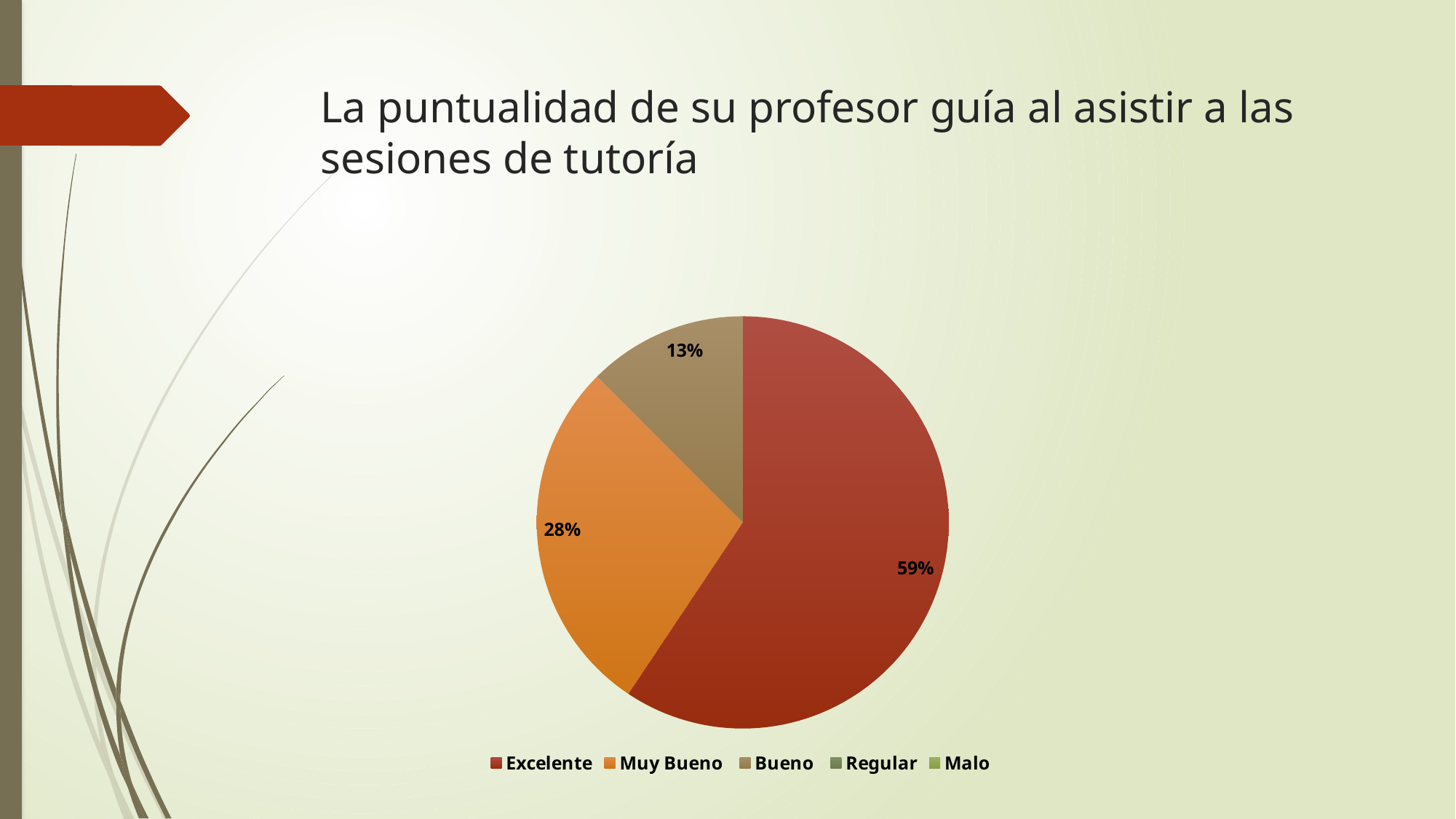
Which is larger, the Muy Bueno slice or the Bueno slice? Muy Bueno What is the title of the slide? La puntualidad de su profesor guía al asistir a las sesiones de tutoría What share of the pie does Bueno have? 13% What colour is the Excelente slice? Red What share of the pie does Muy Bueno have? 28% Which of the labelled slices is the smallest? Bueno Which category has the largest slice of the pie? Excelente What kind of chart is shown on the slide? Pie chart What share of the pie does Excelente have? 59% What is the difference between the Excelente and Muy Bueno shares? 31% How many categories does the legend list? 5 What is the difference between the Muy Bueno and Bueno shares? 15%